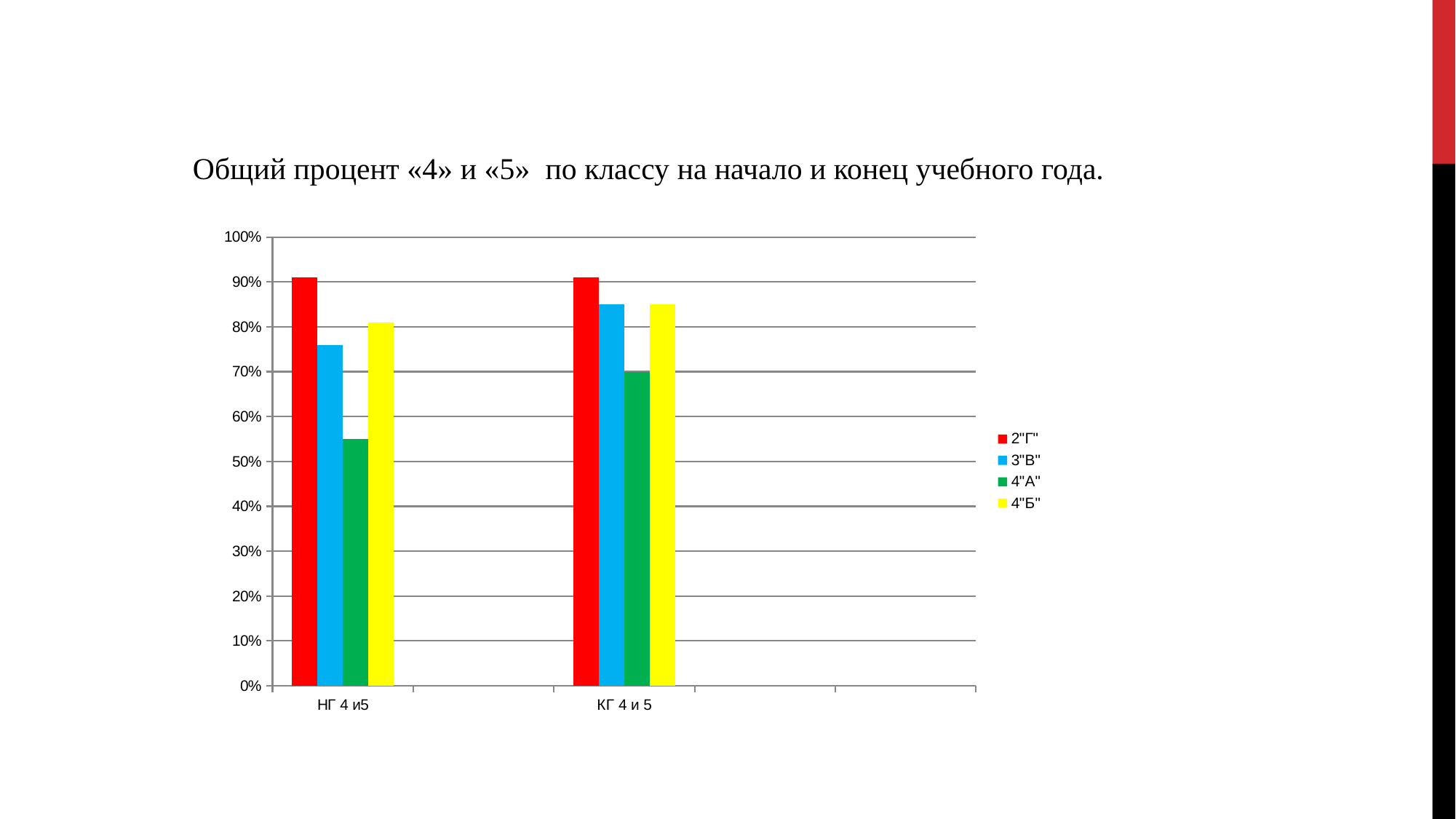
What kind of chart is shown on the slide? bar chart In the "НГ 4 и5" category, which is larger: the value for 3"В" or the value for 4"Б"? 4"Б" Is the value for 4"А" in the "НГ 4 и5" category greater or less than 60%? less Which class has the lowest value in the "НГ 4 и5" category? 4"А" What colour represents 4"Б" in the legend? yellow Which class has the lowest value in the "КГ 4 и 5" category? 4"А" Is the value for 3"В" in the "НГ 4 и5" category greater or less than 70%? greater Which class has the highest value in the "НГ 4 и5" category? 2"Г" How many categories are shown on the x axis? 2 For class 4"А", which category has the larger value: "НГ 4 и5" or "КГ 4 и 5"? КГ 4 и 5 How many series does the legend list? 4 Is the value for 2"Г" in the "КГ 4 и 5" category greater or less than 80%? greater